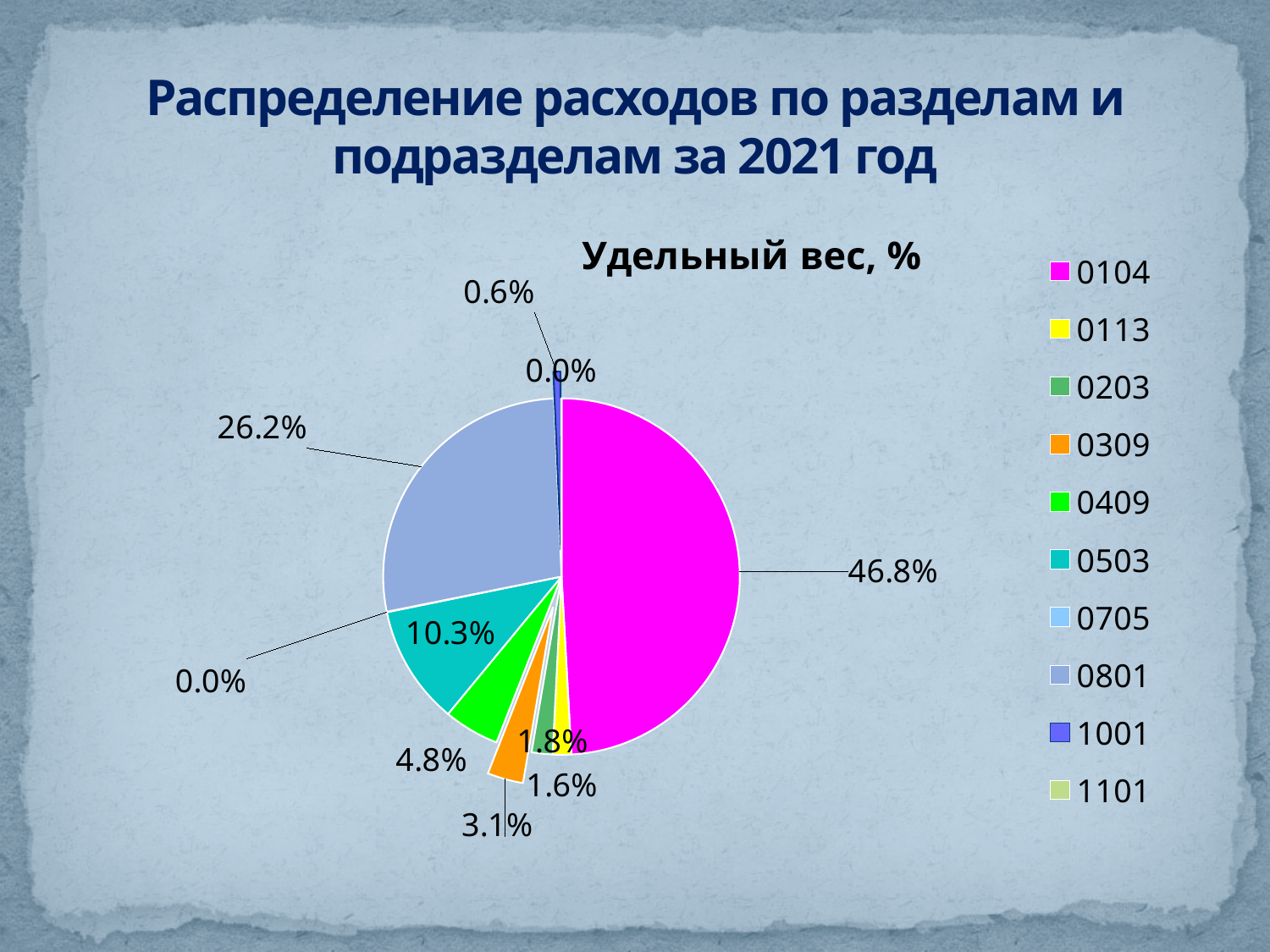
What is the difference between the shares of sections 0104 and 0801? 20.6% What kind of chart is shown on the slide? pie chart Which has the larger share, section 0503 or section 0409? 0503 What is the share for section 0503? 10.3% What is the share for section 0104? 46.8% What is the share for section 0309? 3.1% What is the title of the chart? Удельный вес, % What is the share for section 0409? 4.8% What is the share for section 0801? 26.2% Which section has the largest share of the pie? 0104 What is the share for section 1001? 0.6% How many entries does the chart legend list? 10